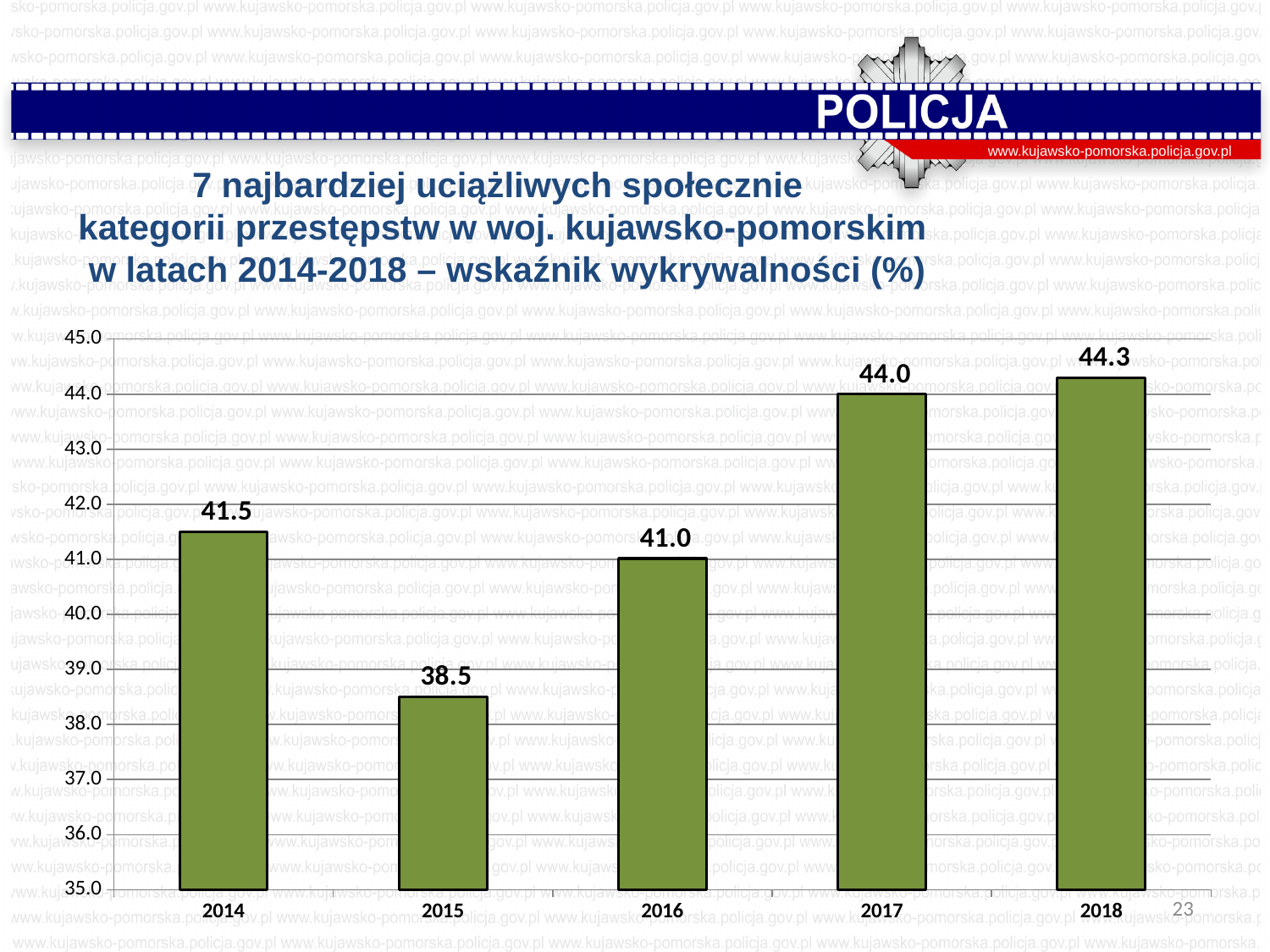
Do the values rise or fall from 2015 to 2018? rise What is the difference between the values for 2014 and 2016? 0.5 What kind of chart is shown on the slide? bar chart What is the detection rate value for 2014? 41.5 What is the value shown for 2015? 38.5 Which is larger, the value for 2014 or the value for 2016? 2014 What is the value shown for 2017? 44.0 How many years are shown on the x axis? 5 Which year has the lowest value? 2015 Which year has the highest value? 2018 Is the value for 2016 greater or less than 40.0? greater What is the difference between the values for 2018 and 2015? 5.8